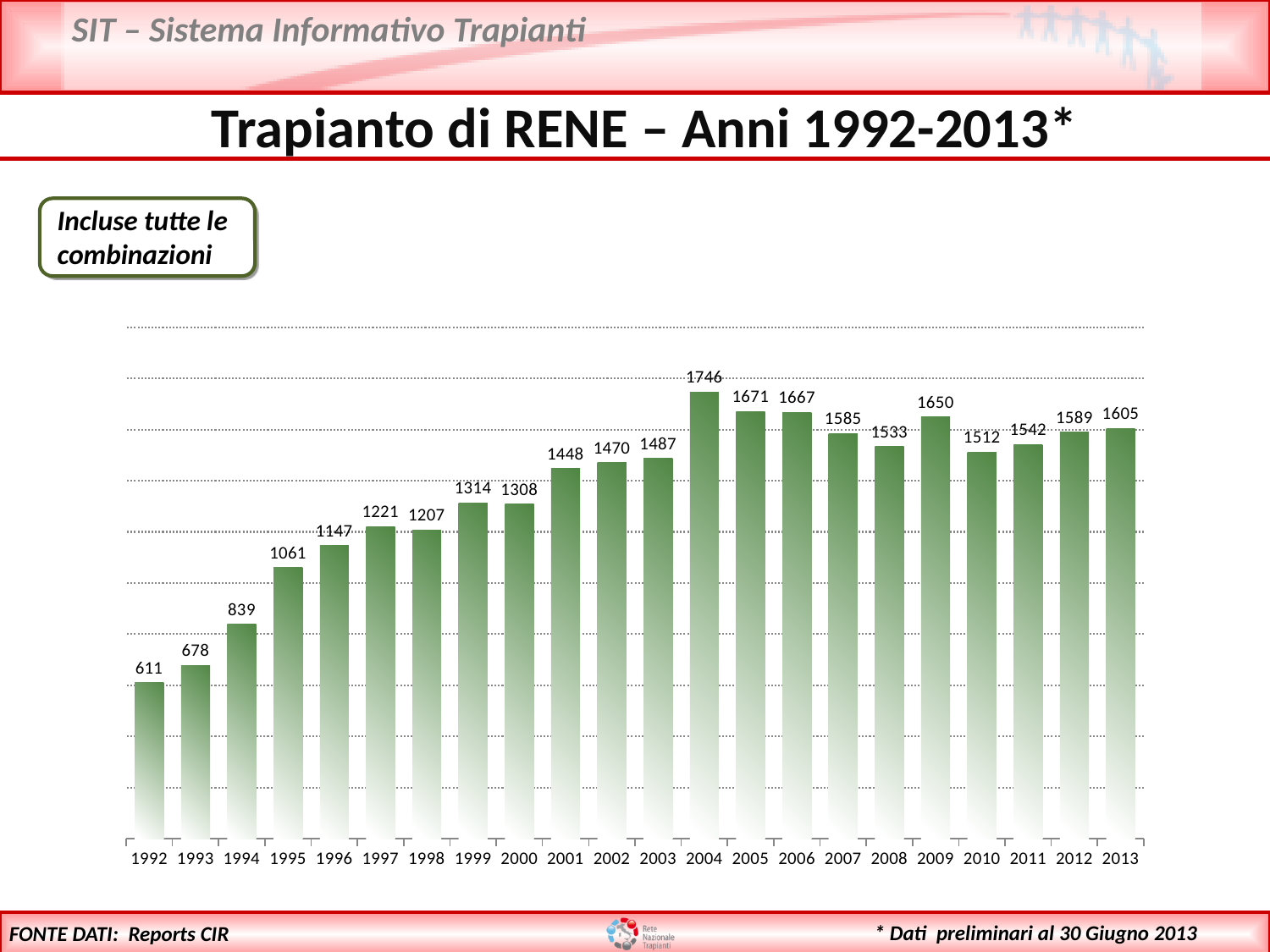
What is the difference between the values for 2013 and 2012? 16 What kind of chart is shown on the slide? bar chart Which year has the lowest value? 1992 What is the value for 2013? 1605 Which is larger, the value for 1999 or the value for 2000? 1999 Which is larger, the value for 2009 or the value for 2010? 2009 What is the value for 1992? 611 What is the value for 2004? 1746 How many years are shown on the x axis? 22 Which year has the highest value? 2004 What is the difference between the values for 2004 and 1992? 1135 Do the values rise or fall from 1992 to 2004? rise